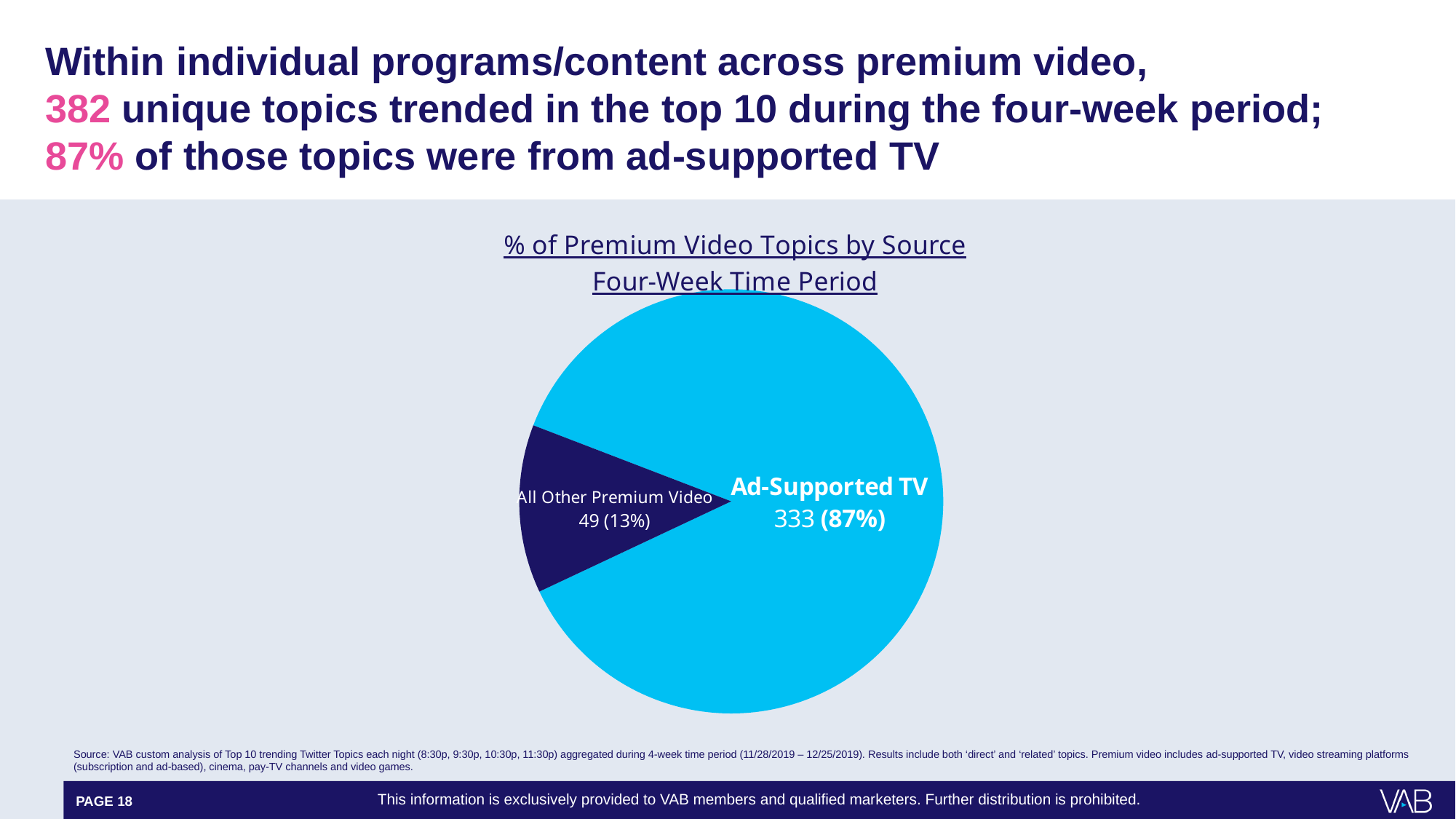
Which slice is larger, Ad-Supported TV or All Other Premium Video? Ad-Supported TV What is the total number of topics across both slices? 382 How many slices does the pie chart have? 2 What is the difference in topic count between Ad-Supported TV and All Other Premium Video? 284 Which slice is the smallest? All Other Premium Video Which slice is the largest? Ad-Supported TV What is the title of the chart? % of Premium Video Topics by Source Four-Week Time Period What share of the pie does Ad-Supported TV represent? 87% What is the value shown for All Other Premium Video? 49 (13%) What type of chart is shown on the slide? pie chart What is the value shown for Ad-Supported TV? 333 (87%) What share of the pie does All Other Premium Video represent? 13%